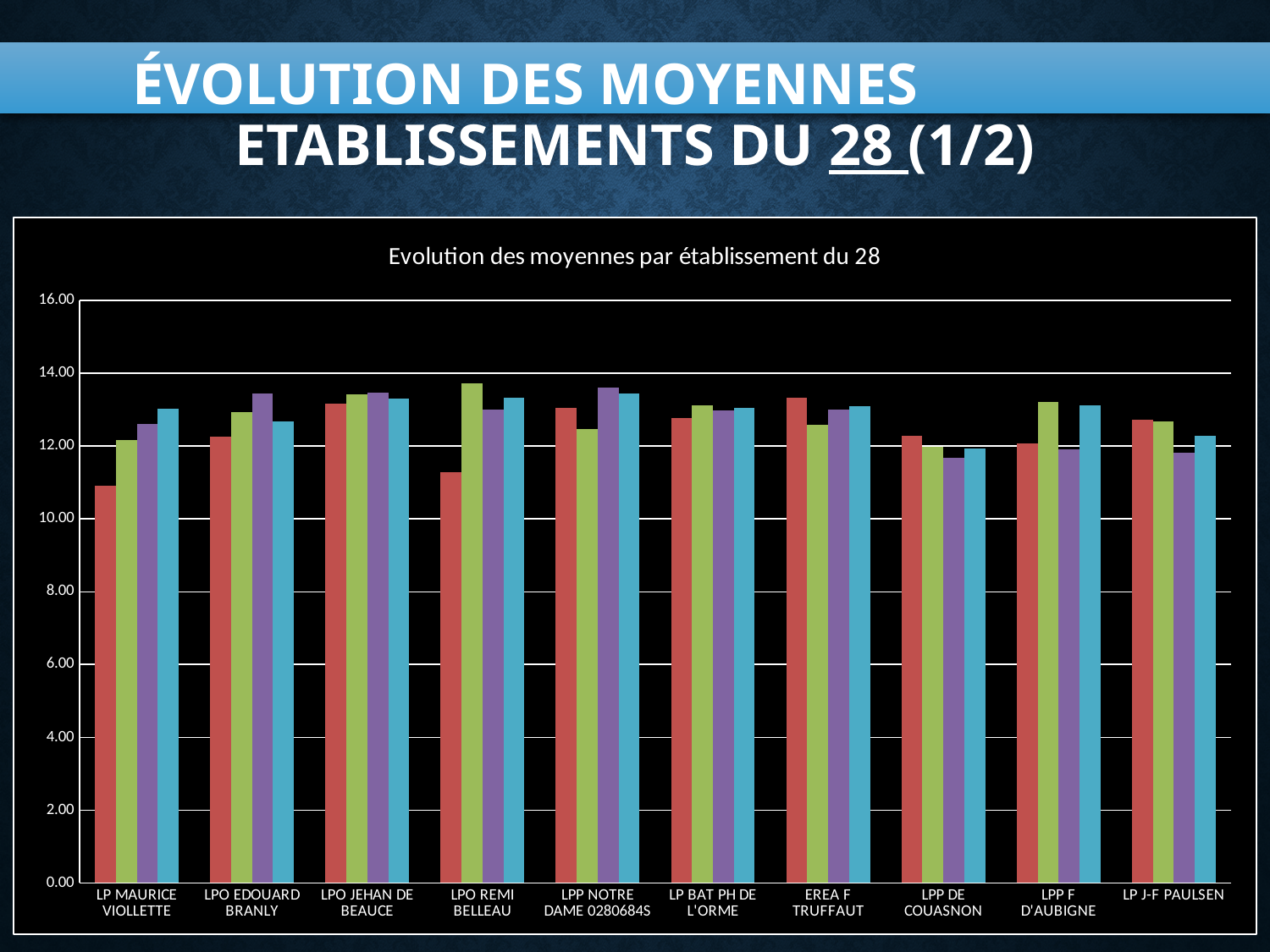
Is the red bar for LPO REMI BELLEAU greater or less than 12.00? less What kind of chart is shown on the slide? bar chart Is the red bar for LP MAURICE VIOLLETTE greater or less than 12.00? less What is the title of the chart? Evolution des moyennes par établissement du 28 What is the highest value shown on the vertical axis of the chart? 16.00 Which is larger: the red bar for LP MAURICE VIOLLETTE or the red bar for LPO JEHAN DE BEAUCE? LPO JEHAN DE BEAUCE How many establishments (categories) are shown on the x axis of the chart? 10 How many bars are plotted for each establishment in the chart? 4 Is the blue bar for LP MAURICE VIOLLETTE greater or less than 12.00? greater Which establishment has the lowest red bar in the chart? LP MAURICE VIOLLETTE